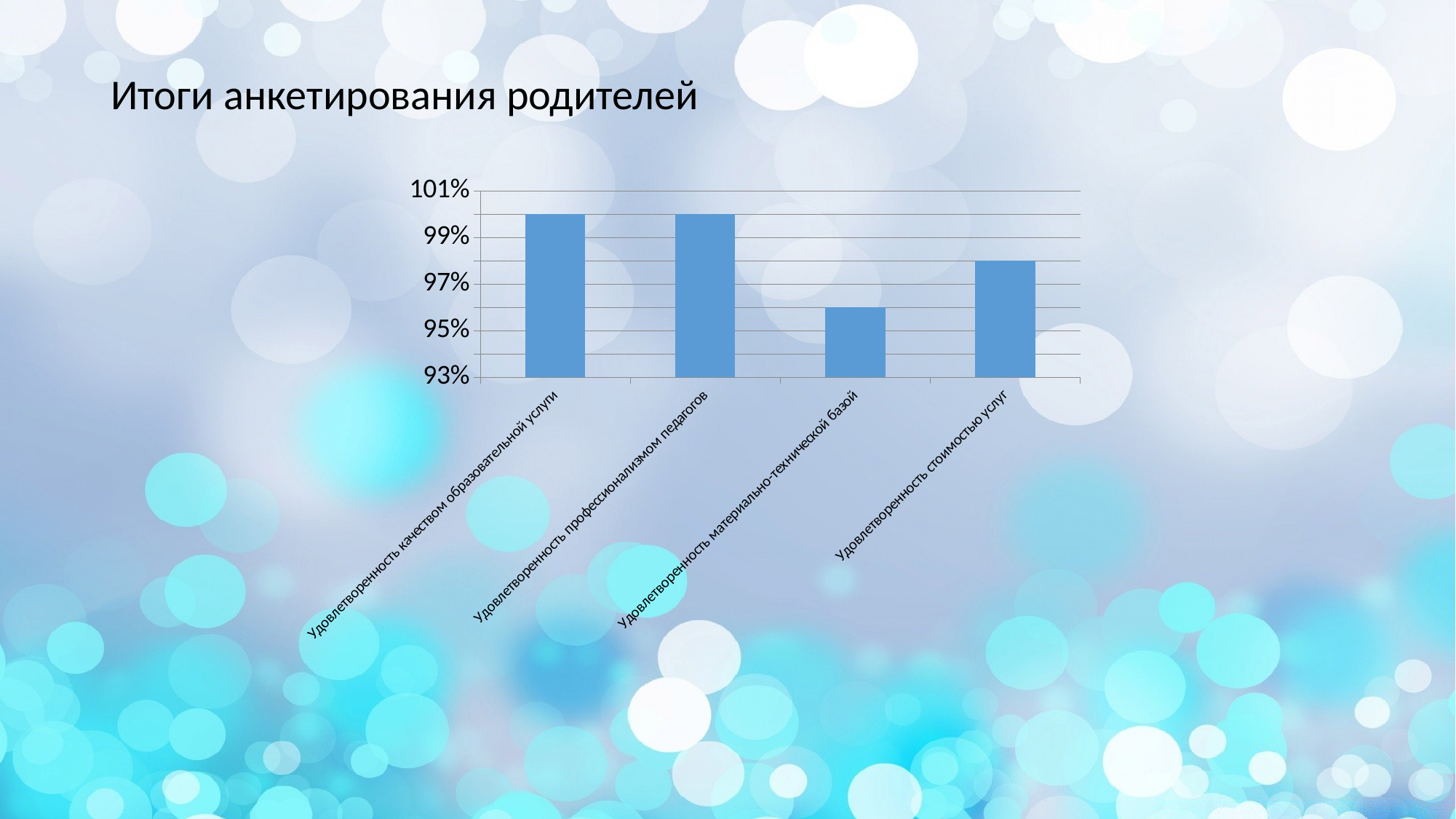
What kind of chart is shown on the slide? bar chart Which is larger: the value for Удовлетворенность профессионализмом педагогов or for Удовлетворенность материально-технической базой? Удовлетворенность профессионализмом педагогов Is the value for Удовлетворенность стоимостью услуг greater or less than 97%? greater Is the value for Удовлетворенность качеством образовательной услуги greater or less than 99%? greater What is the title of the slide above the chart? Итоги анкетирования родителей Is the value for Удовлетворенность материально-технической базой greater or less than 97%? less What is the lowest value labelled on the vertical axis of the chart? 93% Which is larger: the value for Удовлетворенность стоимостью услуг or for Удовлетворенность материально-технической базой? Удовлетворенность стоимостью услуг Which category has the lowest value in the chart? Удовлетворенность материально-технической базой How many categories are shown in the chart? 4